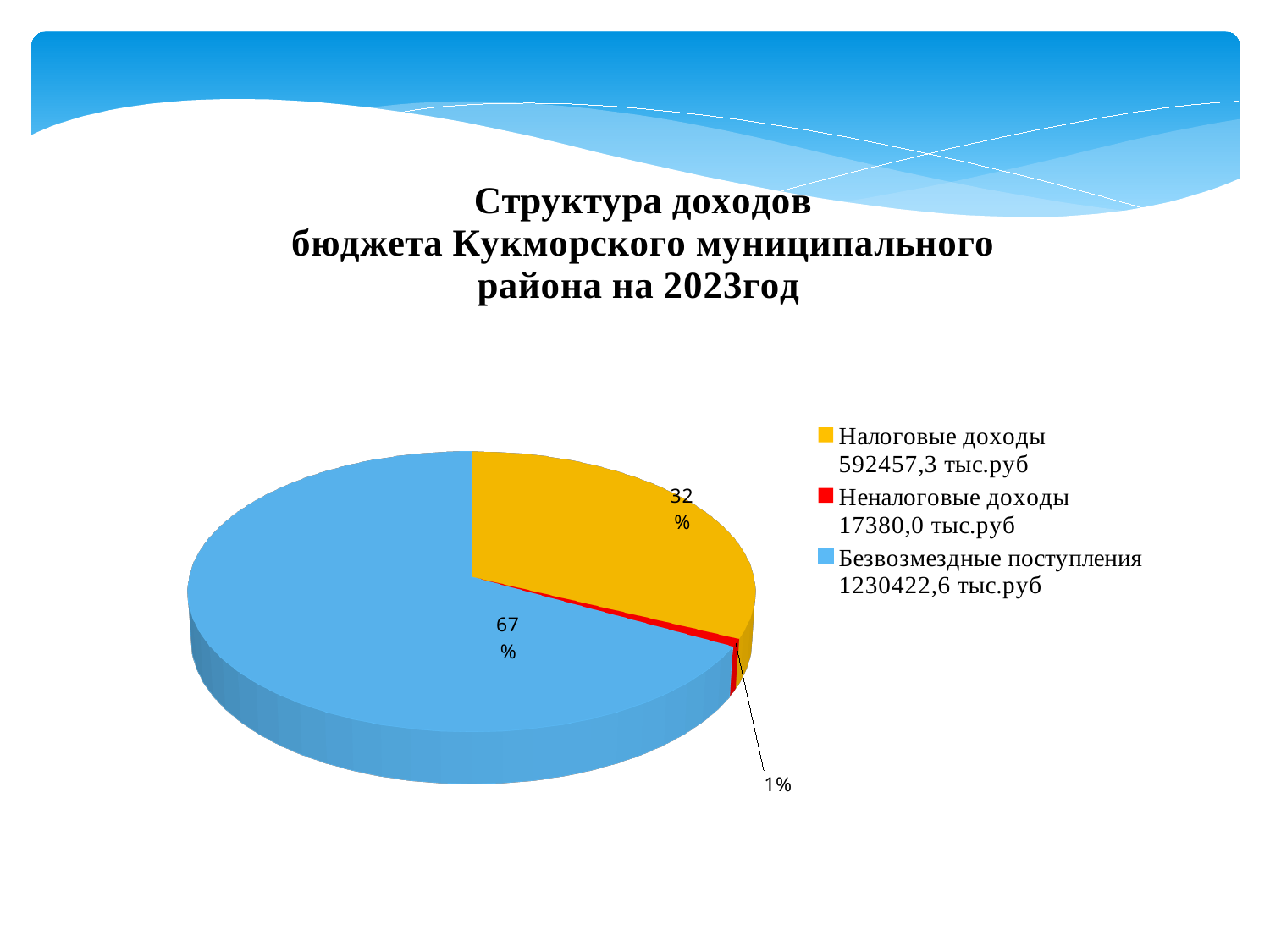
Which category has the largest share of the pie? Безвозмездные поступления What share of the pie does Безвозмездные поступления take? 67% What kind of chart is shown on the slide? pie chart What amount is given in the legend for Налоговые доходы? 592457,3 тыс.руб What amount is given in the legend for Неналоговые доходы? 17380,0 тыс.руб What share of the pie does Налоговые доходы take? 32% What share of the pie does Неналоговые доходы take? 1% How many entries does the legend list? 3 What amount is given in the legend for Безвозмездные поступления? 1230422,6 тыс.руб How many slices does the pie chart have? 3 Which category has the smallest share of the pie? Неналоговые доходы Which colour represents Налоговые доходы in the pie chart? yellow